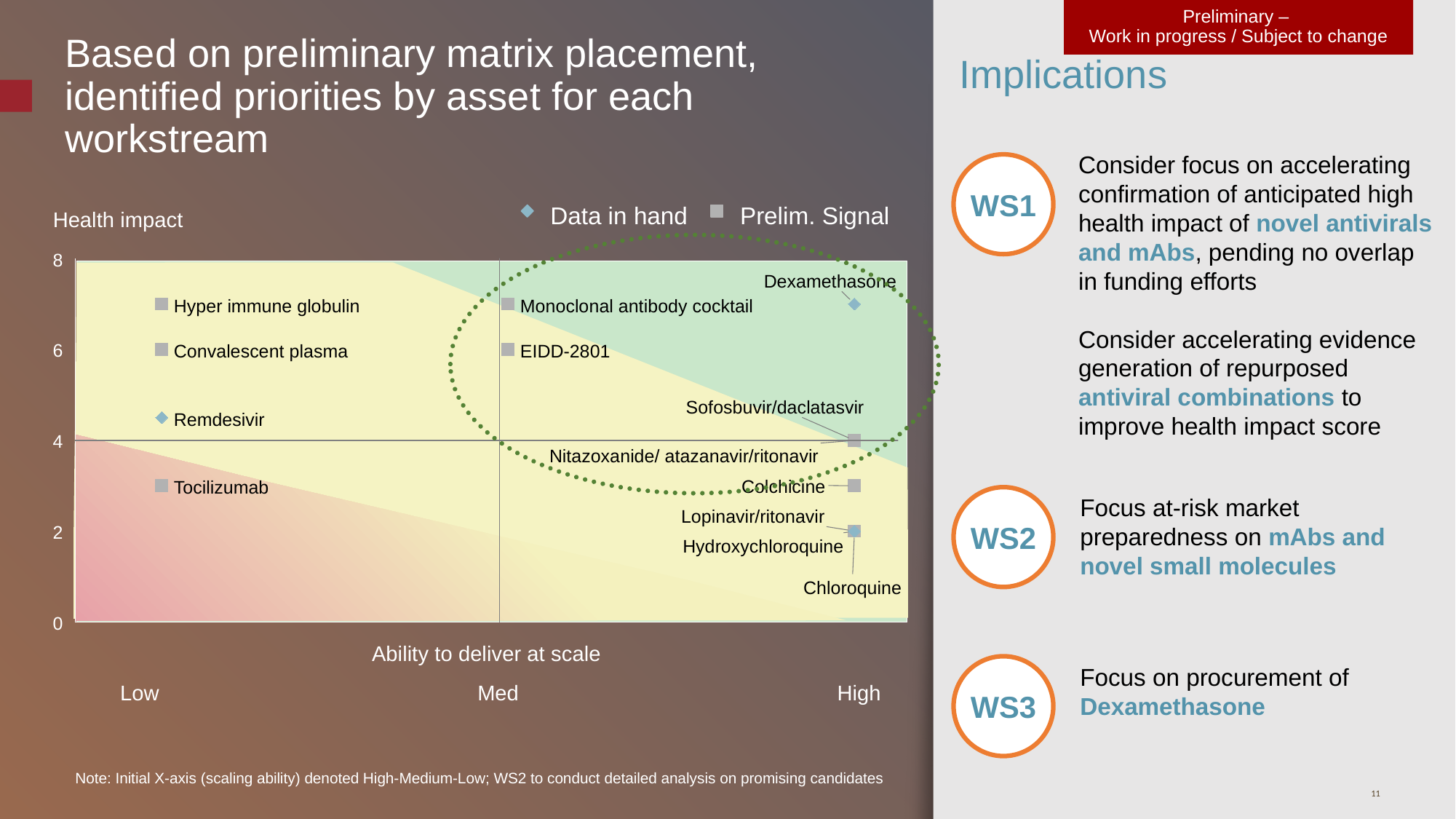
What kind of chart is shown on the slide? Scatter chart How many labelled assets are plotted on the chart? 13 What is the title of the vertical axis of the chart? Health impact Which asset in the Low ability-to-deliver column is marked as 'Data in hand'? Remdesivir How many series does the chart legend list? 2 Is the health impact value for Dexamethasone greater or less than 6? greater Which has the higher health impact, Dexamethasone or Chloroquine? Dexamethasone Is the health impact value for Colchicine greater or less than 4? less Which has the higher health impact, Hyper immune globulin or Tocilizumab? Hyper immune globulin What are the two legend entries of the chart? Data in hand; Prelim. Signal Is the health impact value for Hyper immune globulin greater or less than 6? greater